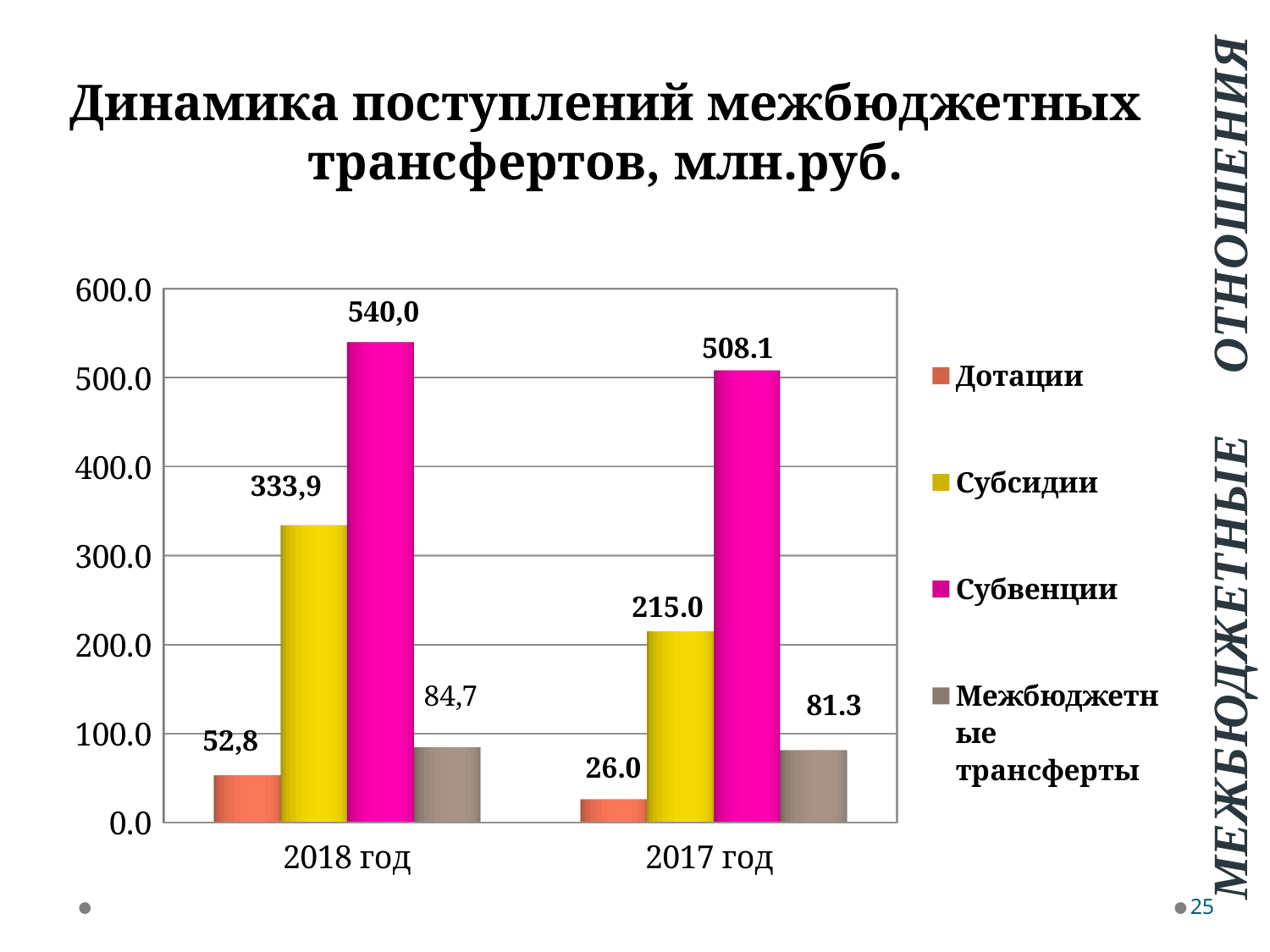
What is the value for Субсидии in 2017 год? 215.0 What kind of chart is shown on the slide? Bar chart Which is larger: Субсидии in 2018 год or Субсидии in 2017 год? Субсидии in 2018 год Which series has the highest value in 2017 год? Субвенции What is the title of the chart? Динамика поступлений межбюджетных трансфертов, млн.руб. Which series has the lowest value in 2018 год? Дотации What is the value for Межбюджетные трансферты in 2017 год? 81.3 What is the difference between Субвенции and Субсидии in 2017 год? 293.1 What is the value for Дотации in 2018 год? 52,8 What is the difference between Субвенции and Субсидии in 2018 год? 206,1 What is the value for Субвенции in 2018 год? 540,0 How many series does the legend list? 4